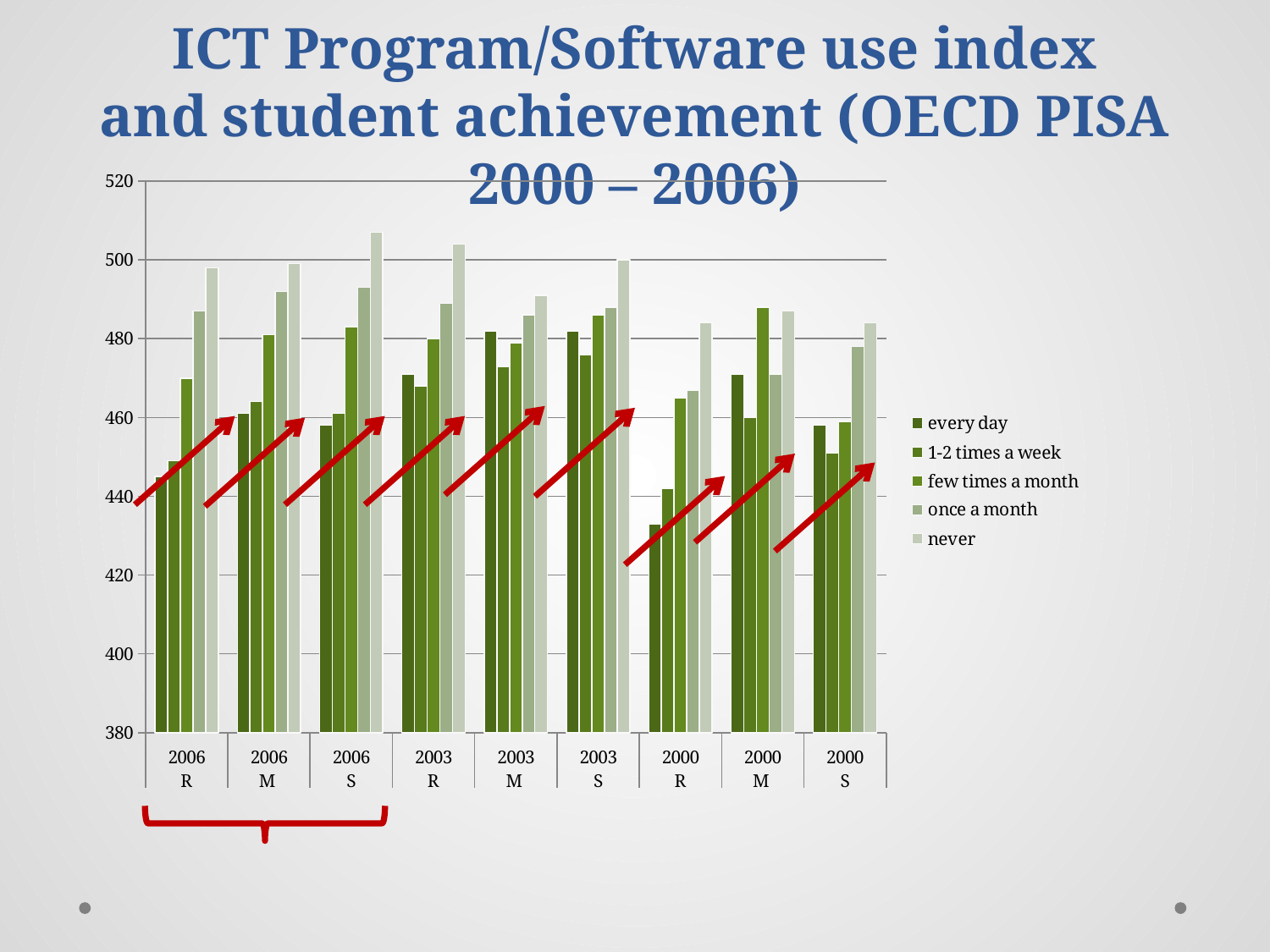
Within the 2006 R group, do the values rise or fall going from 'every day' to 'never'? rise How many series does the legend list? 5 Is the value for 'every day' in the 2000 R group greater or less than 440? less How many category groups are shown along the x axis? 9 Which series has the highest value in the 2006 R group? never Which legend entry is shown with the lightest colour? never Is the value for 'once a month' in the 2006 M group greater or less than 480? greater Which series has the lowest value in the 2000 R group? every day Is the value for 'never' in the 2006 S group greater or less than 500? greater In the 2006 S group, which is larger: the value for 'never' or the value for 'every day'? never What kind of chart is shown on the slide? bar chart